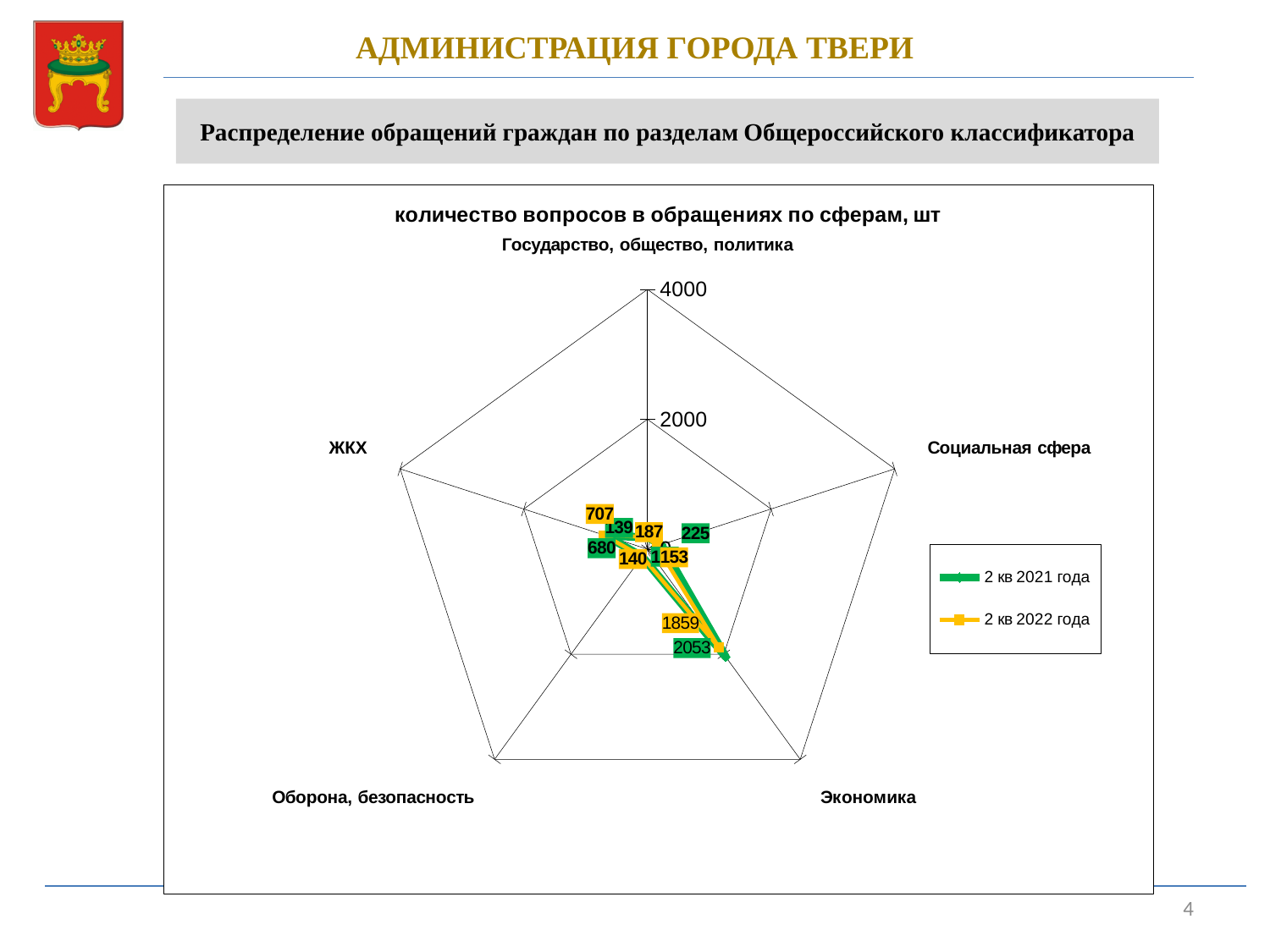
How many categories (axes) does the radar chart have? 5 What is the value for ЖКХ in 2 кв 2022 года? 707 What is the value for ЖКХ in 2 кв 2021 года? 680 What is the difference between the Экономика values for 2 кв 2021 года and 2 кв 2022 года? 194 How many series does the legend list? 2 What is the value for Экономика in 2 кв 2021 года? 2053 What kind of chart is shown on the slide? radar chart What is the value for Экономика in 2 кв 2022 года? 1859 Which series is shown in yellow according to the legend? 2 кв 2022 года What is the title of the chart? количество вопросов в обращениях по сферам, шт Which category has the highest value in 2 кв 2021 года? Экономика Is the value for Экономика in 2 кв 2022 года greater or less than 2000? less